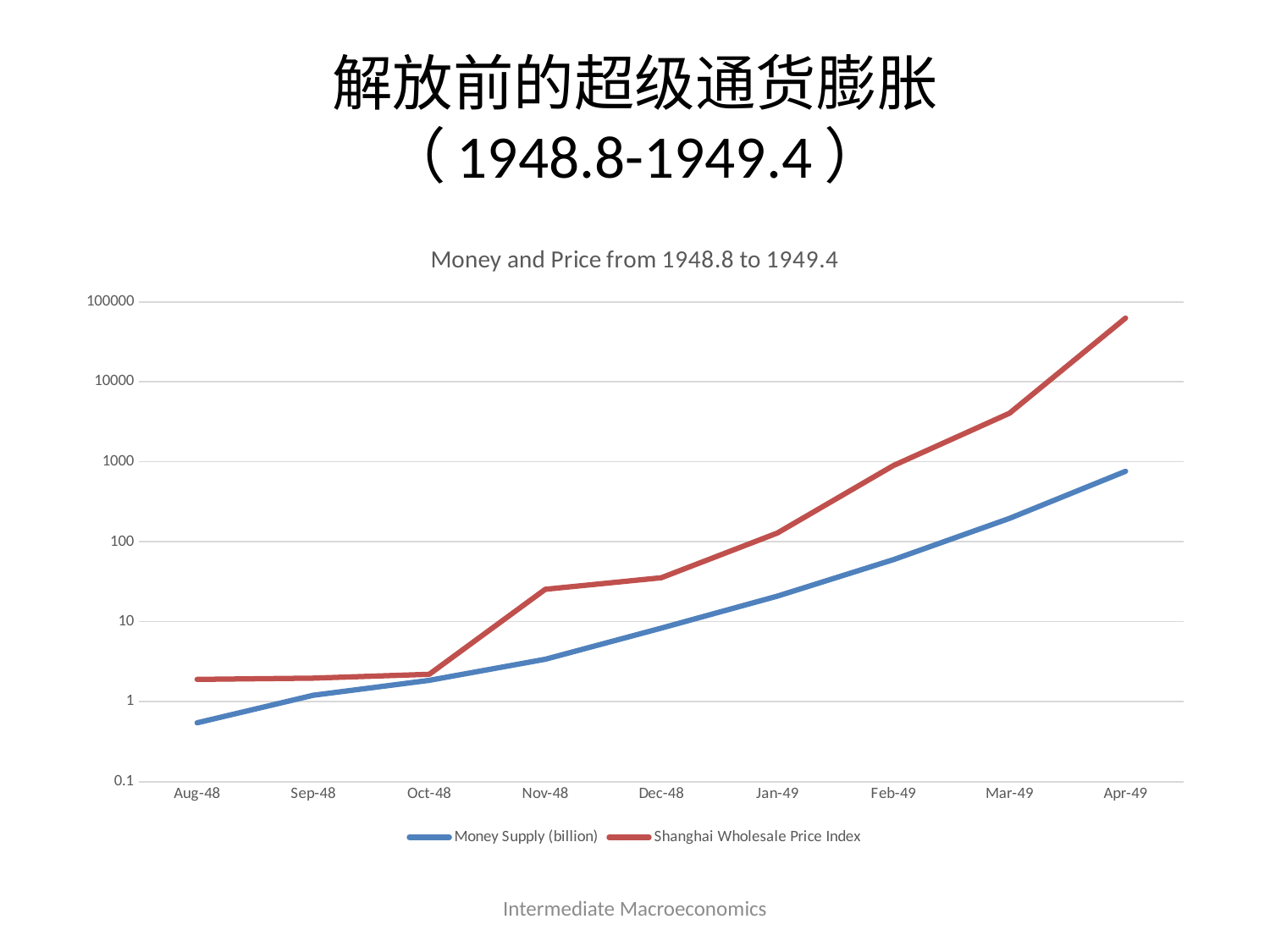
In which month is the Shanghai Wholesale Price Index highest? Apr-49 Is the Money Supply (billion) for Aug-48 greater or less than 1? less What kind of chart is shown on the slide? line chart Is the Shanghai Wholesale Price Index for Mar-49 greater or less than 1000? greater Is the Shanghai Wholesale Price Index for Apr-49 greater or less than 10000? greater In which month is the Money Supply (billion) lowest? Aug-48 How many series does the legend list? 2 Do the Money Supply (billion) values rise or fall from Aug-48 to Apr-49? rise What is the title of the chart? Money and Price from 1948.8 to 1949.4 How many months are plotted along the x axis? 9 In Apr-49, which is larger: the Money Supply (billion) or the Shanghai Wholesale Price Index? Shanghai Wholesale Price Index